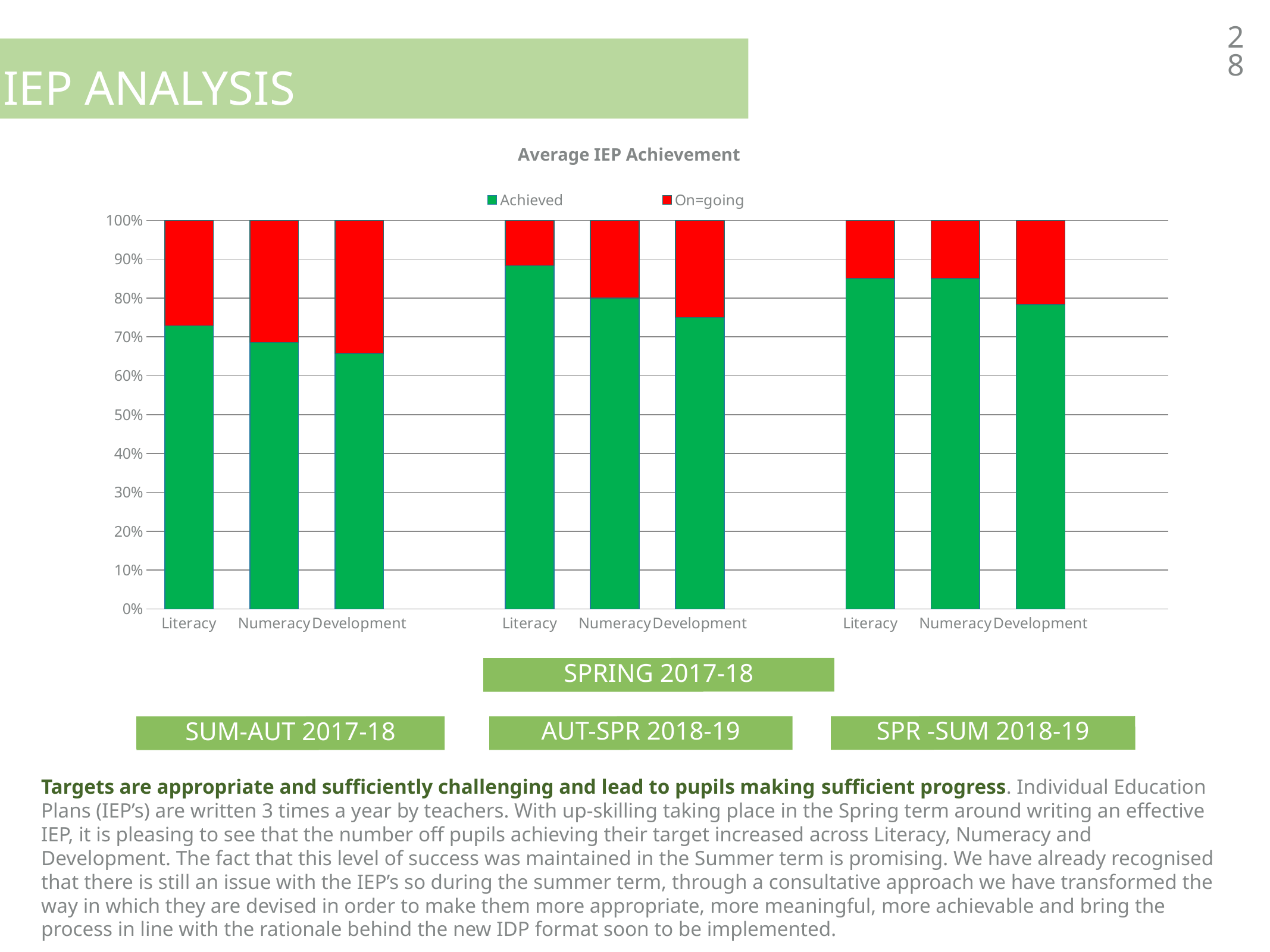
Is the Achieved value for Development in the AUT-SPR 2018-19 group greater or less than 70%? greater What is the title of the chart on the slide? Average IEP Achievement Which bar has the highest Achieved share in the Average IEP Achievement chart? Literacy in AUT-SPR 2018-19 What kind of chart is shown on the slide? Stacked bar chart Is the Achieved value for Development in the SUM-AUT 2017-18 group greater or less than 70%? less Is the Achieved value for Literacy in the AUT-SPR 2018-19 group greater or less than 80%? greater What are the two legend entries in the Average IEP Achievement chart? Achieved and On=going What is the total of each stacked bar in the Average IEP Achievement chart? 100% How many stacked bars are plotted in the Average IEP Achievement chart? 9 Which is larger: the Achieved share for Literacy in SUM-AUT 2017-18 or for Literacy in AUT-SPR 2018-19? Literacy in AUT-SPR 2018-19 How many series does the legend of the Average IEP Achievement chart list? 2